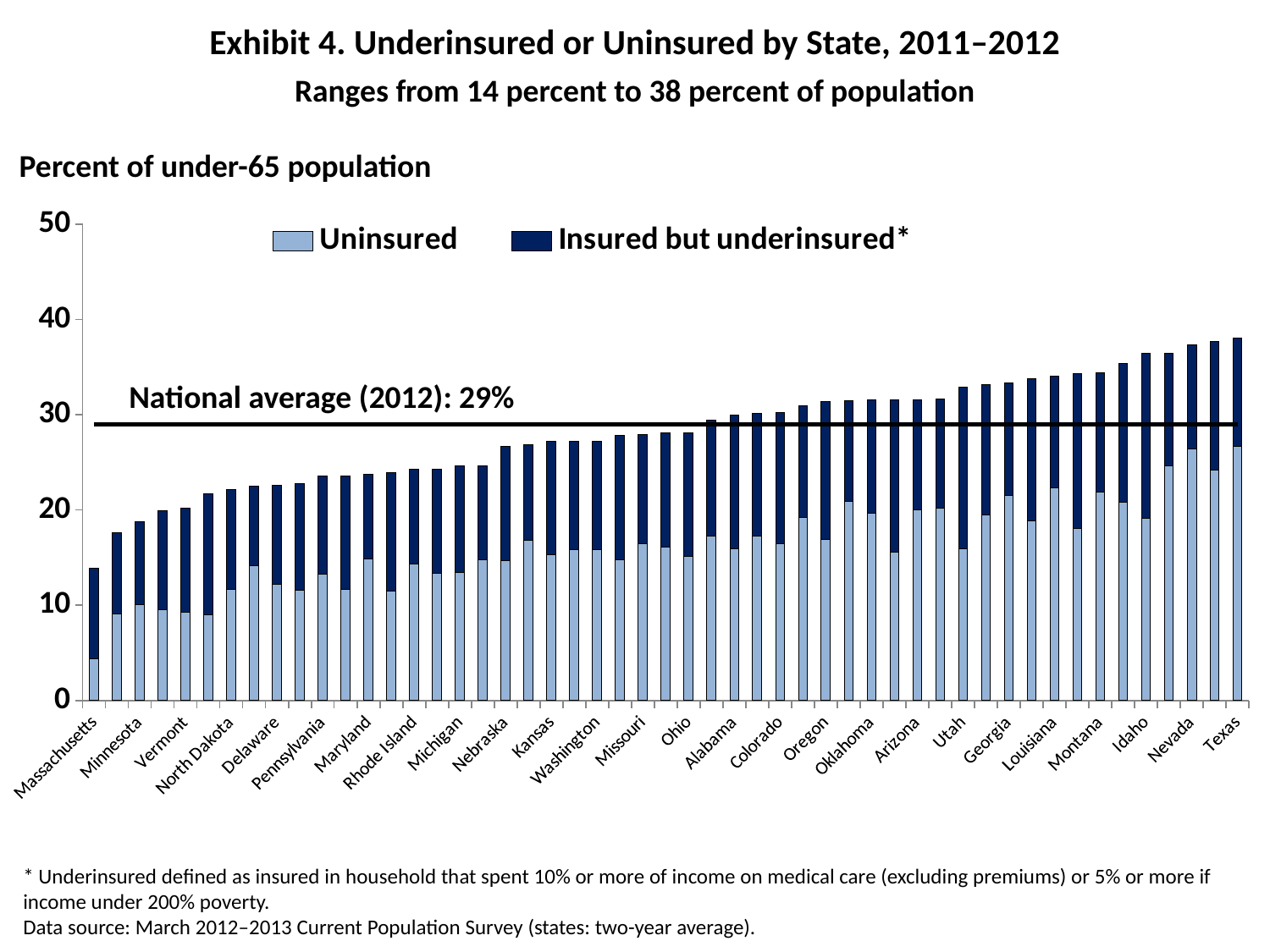
Which state has the highest total underinsured or uninsured percentage? Texas Is the total value for Texas greater or less than 30? greater What kind of chart is shown on the slide? Stacked bar chart How many series does the legend list? 2 Do the total bar heights rise or fall moving from left to right along the x axis? Rise What national average (2012) is marked by the horizontal line on the chart? 29% Is the Uninsured value for Massachusetts greater or less than 10? less Is the Uninsured value for Texas greater or less than 20? greater Which state has the lowest total underinsured or uninsured percentage? Massachusetts Which has a larger total value, Utah or Ohio? Utah